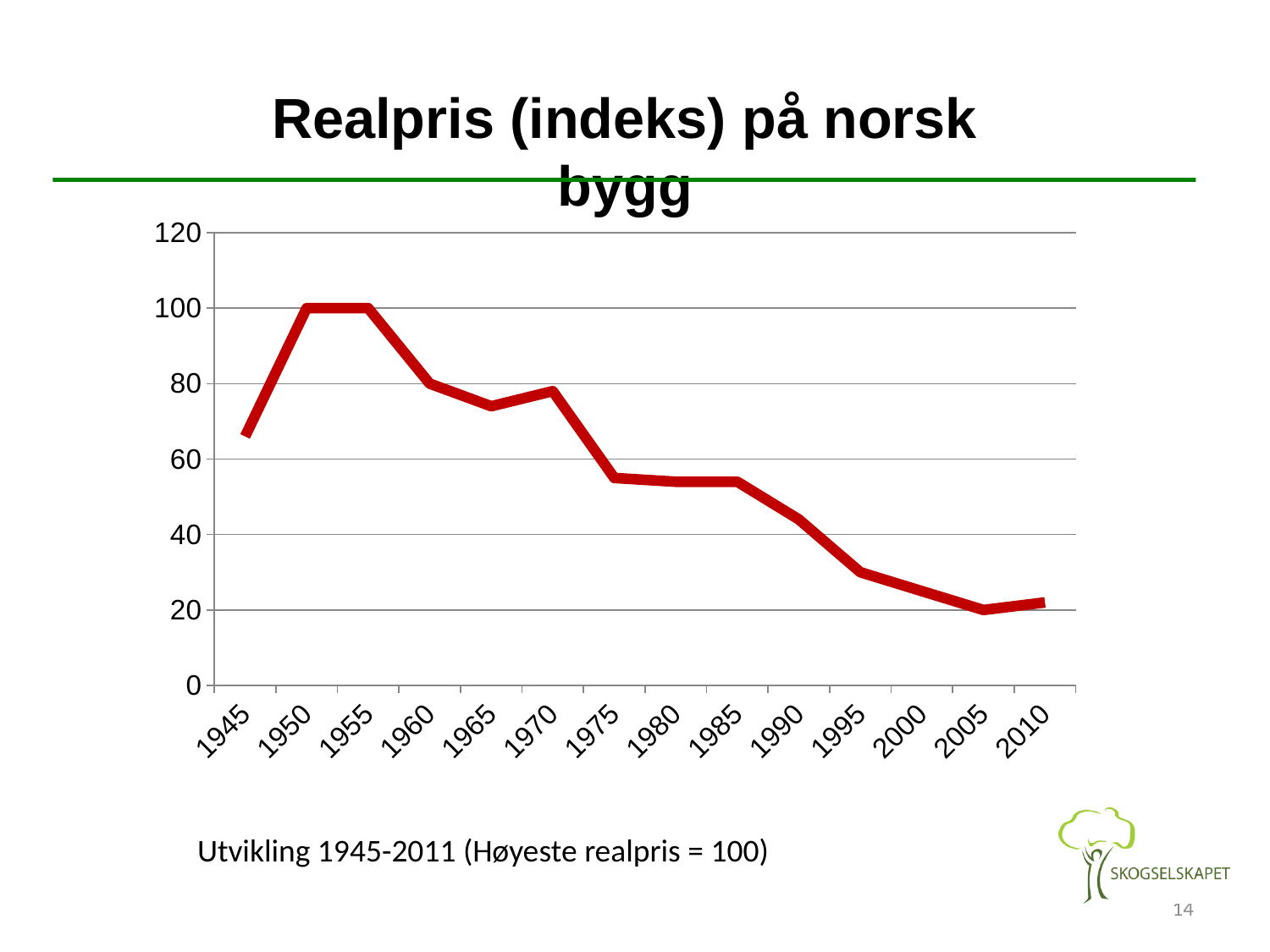
How many years are labelled on the x axis of the chart? 14 What is the title of the chart? Realpris (indeks) på norsk bygg What colour is the line in the chart? red Is the value for 1945 greater or less than 60? greater Which year has the larger value, 1945 or 1975? 1945 Is the value for 1975 greater or less than 60? less What is the index value for 1955? 100 What is the index value for 1950? 100 Do the values generally rise or fall from 1955 to 2005? fall What kind of chart is shown on the slide? line chart Is the value for 1995 greater or less than 40? less